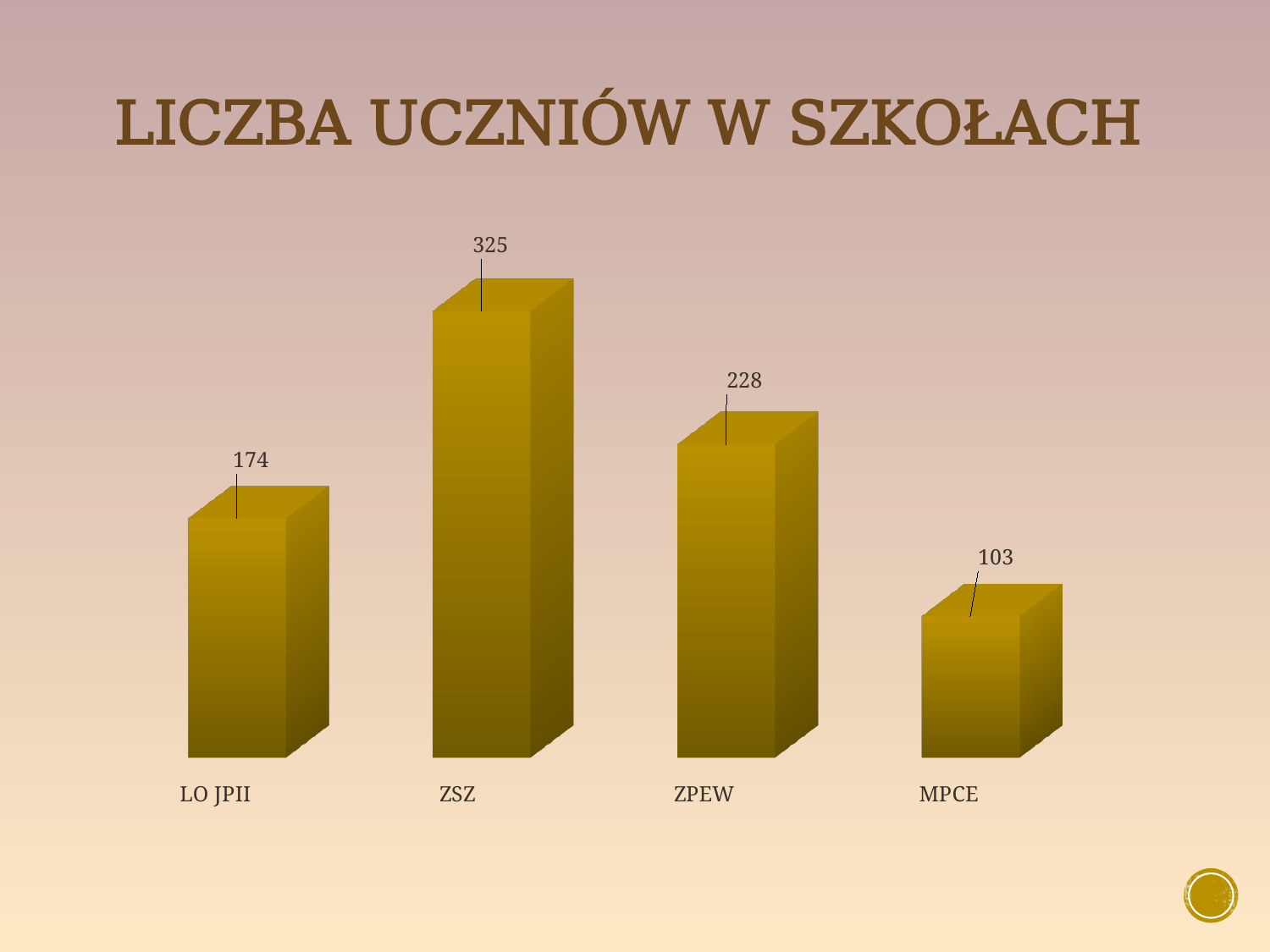
What is the value for LO JPII? 174 Which school has the lowest number of students? MPCE What is the difference between the values for LO JPII and MPCE? 71 How many schools are shown in the chart? 4 What kind of chart is shown on the slide? bar chart What is the value for ZPEW? 228 Which school has the highest number of students? ZSZ What is the value for MPCE? 103 What is the difference between the values for ZSZ and ZPEW? 97 Which is larger, the value for LO JPII or the value for ZPEW? ZPEW What is the value for ZSZ? 325 What is the title of the chart? LICZBA UCZNIÓW W SZKOŁACH